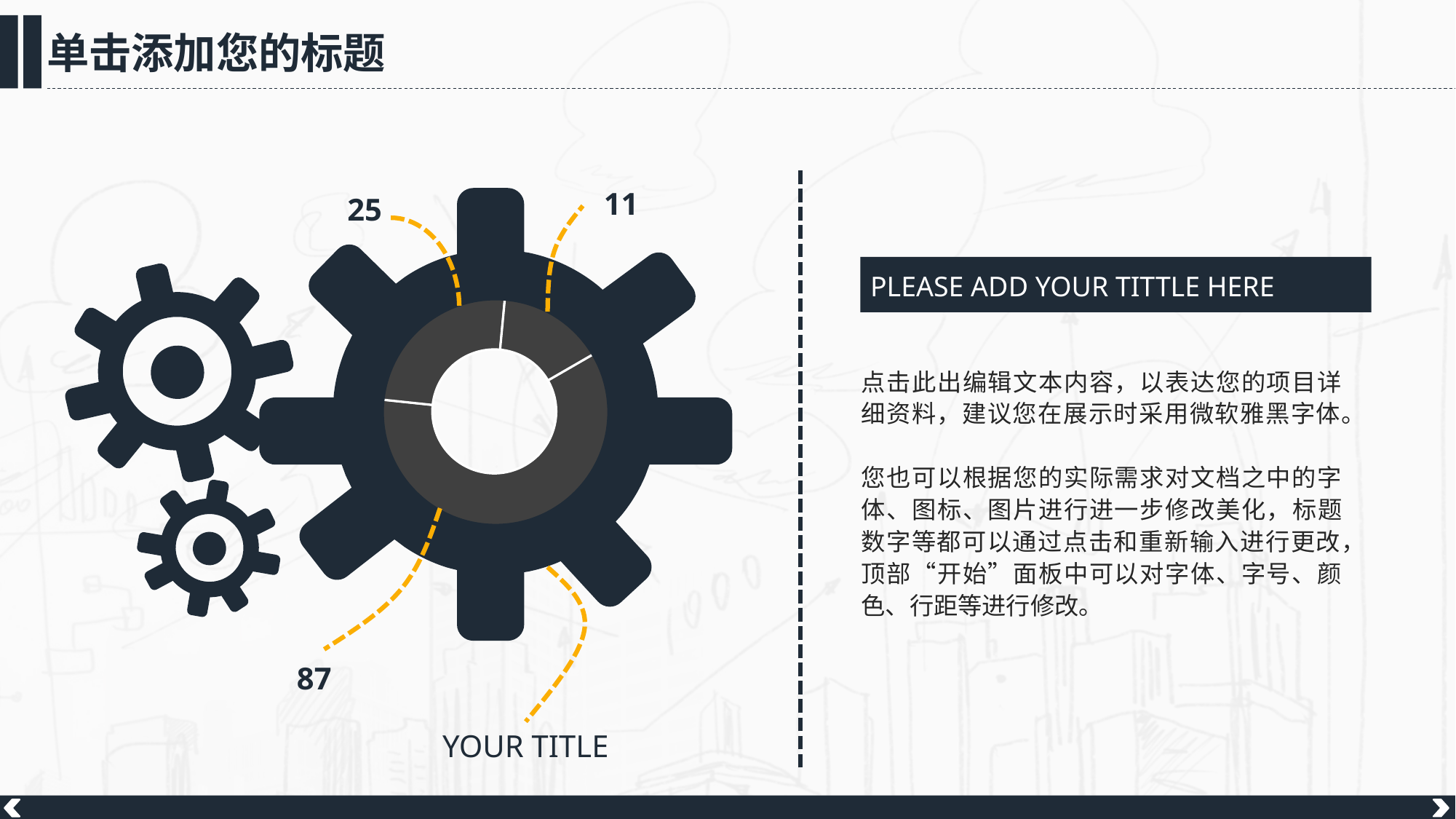
What are the three values labeled on the doughnut chart? 25, 11, 87 Is the largest slice of the doughnut chart labeled with a value greater or less than 50? greater What title text appears below the doughnut chart? YOUR TITLE What is the value labeled on the smallest slice of the doughnut chart? 11 What is the difference between the slices labeled 87 and 25 on the doughnut chart? 62 What colour are the dashed callout lines connecting the values to the doughnut chart? Orange/yellow How many slices does the doughnut chart have? 3 What kind of chart is shown inside the large gear on the slide? Doughnut (pie) chart What is the difference between the slices labeled 25 and 11 on the doughnut chart? 14 Which is larger on the doughnut chart, the slice labeled 25 or the slice labeled 11? 25 What is the value labeled on the largest slice of the doughnut chart? 87 What is the difference between the largest labeled value (87) and the smallest labeled value (11) on the doughnut chart? 76